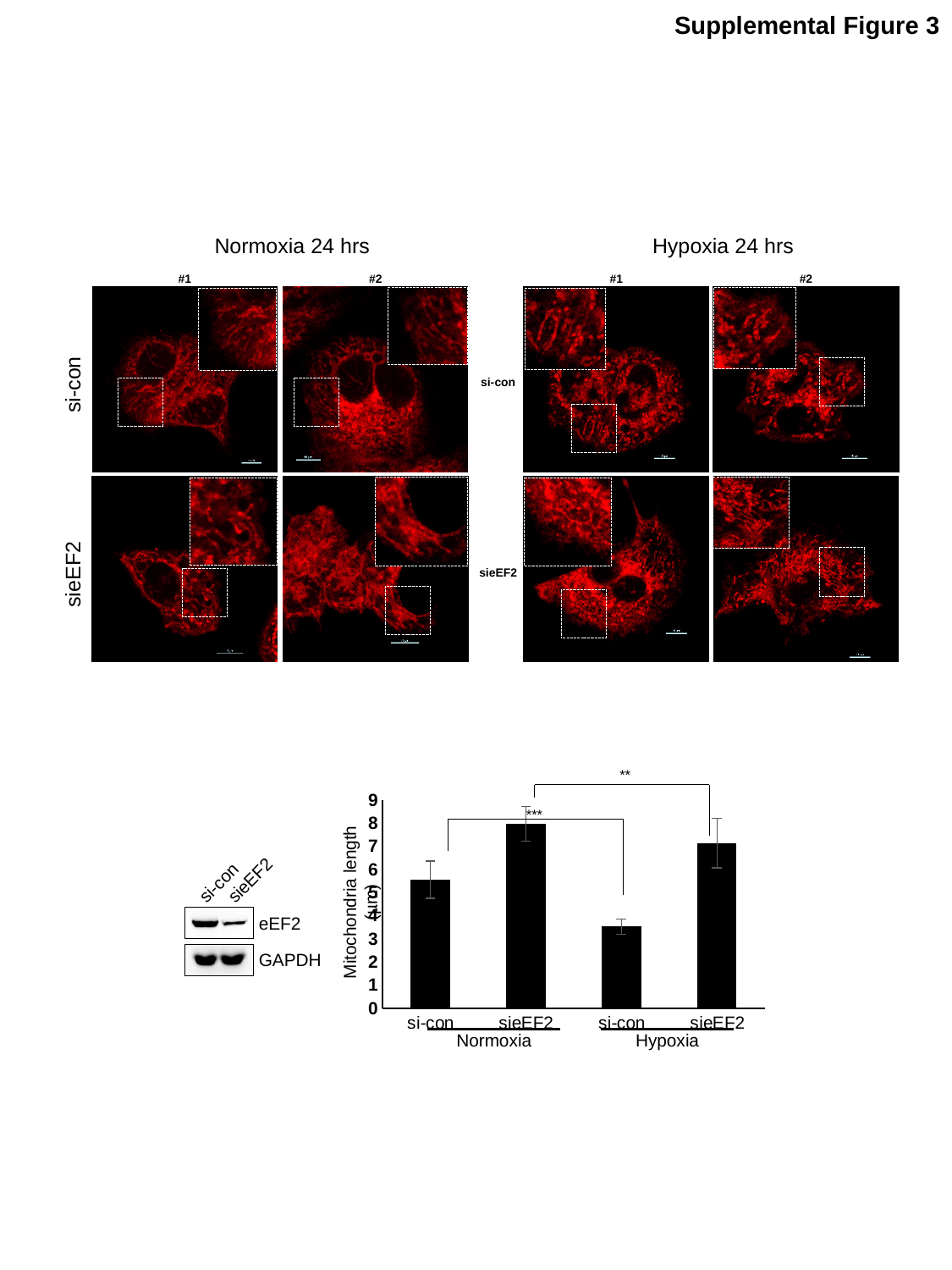
What kind of chart is shown at the bottom of the slide? bar chart In the bar chart, which is larger: the mitochondria length for sieEF2 under Hypoxia or for si-con under Normoxia? sieEF2 under Hypoxia In the bar chart, is the mitochondria length for si-con under Normoxia greater or less than 5? greater What is the y-axis label of the bar chart? Mitochondria length (μm) Which bar has the lowest mitochondria length in the bar chart? si-con under Hypoxia Which bar has the highest mitochondria length in the bar chart? sieEF2 under Normoxia In the bar chart, which is larger: the mitochondria length for si-con under Normoxia or for si-con under Hypoxia? si-con under Normoxia What are the two condition groups labelled on the x-axis of the bar chart? Normoxia and Hypoxia In the bar chart, is the mitochondria length for sieEF2 under Hypoxia greater or less than 6? greater In the bar chart, is the mitochondria length for sieEF2 under Normoxia greater or less than 7? greater How many bars are plotted in the Mitochondria length chart? 4